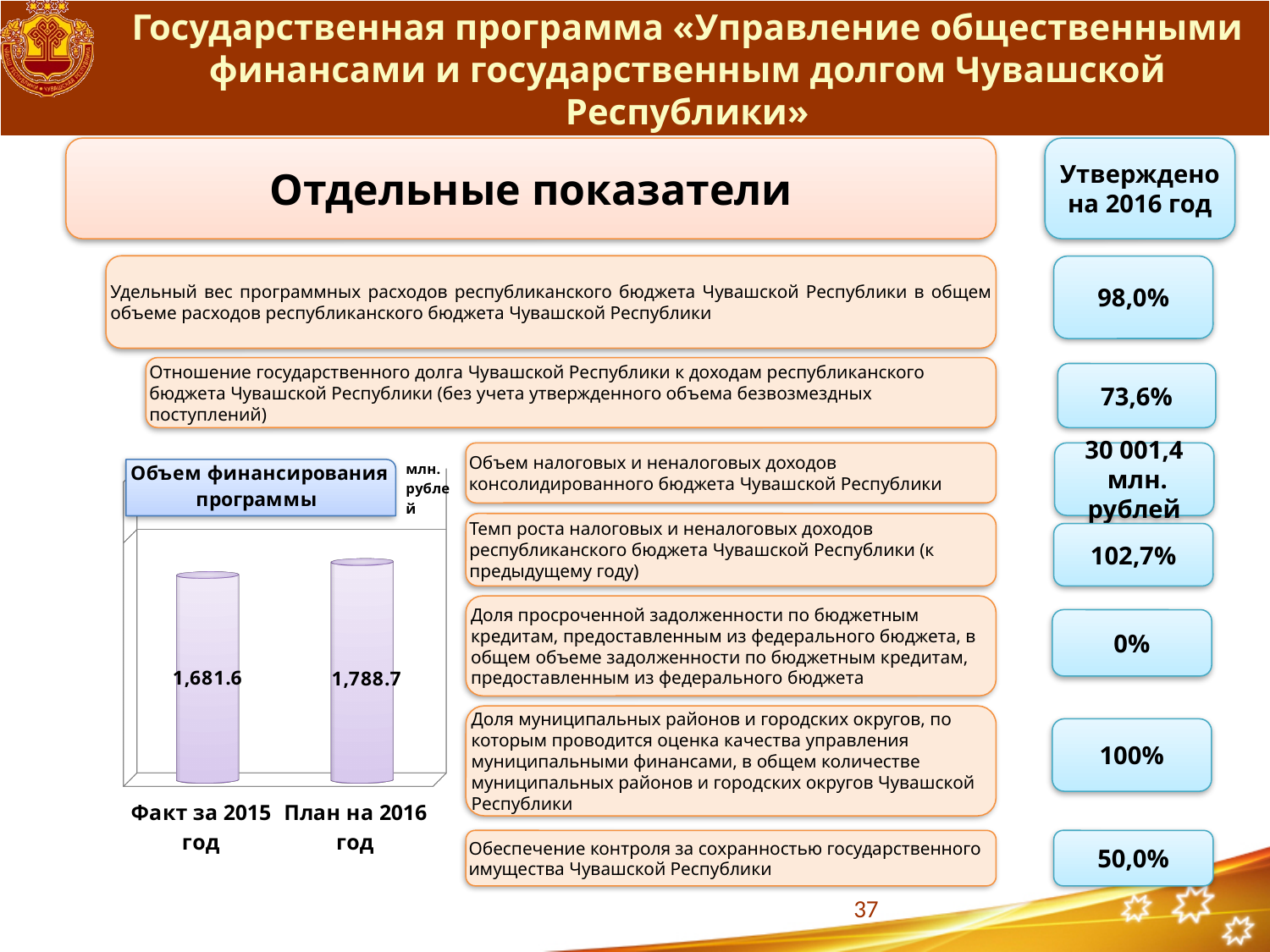
What unit is indicated for the values in the 'Объем финансирования программы' chart? млн. рублей Which category has the lowest value in the 'Объем финансирования программы' chart? Факт за 2015 год How many categories are shown in the 'Объем финансирования программы' chart? 2 What kind of chart is the 'Объем финансирования программы' chart? Bar chart Do the values rise or fall from 'Факт за 2015 год' to 'План на 2016 год' in the 'Объем финансирования программы' chart? Rise What is the difference between the values for 'План на 2016 год' and 'Факт за 2015 год' in the 'Объем финансирования программы' chart? 107.1 What is the value for 'План на 2016 год' in the 'Объем финансирования программы' chart? 1,788.7 Which category has the highest value in the 'Объем финансирования программы' chart? План на 2016 год What is the title of the bar chart on the slide? Объем финансирования программы In the 'Объем финансирования программы' chart, which is larger: the value for 'Факт за 2015 год' or for 'План на 2016 год'? План на 2016 год What is the value for 'Факт за 2015 год' in the 'Объем финансирования программы' chart? 1,681.6